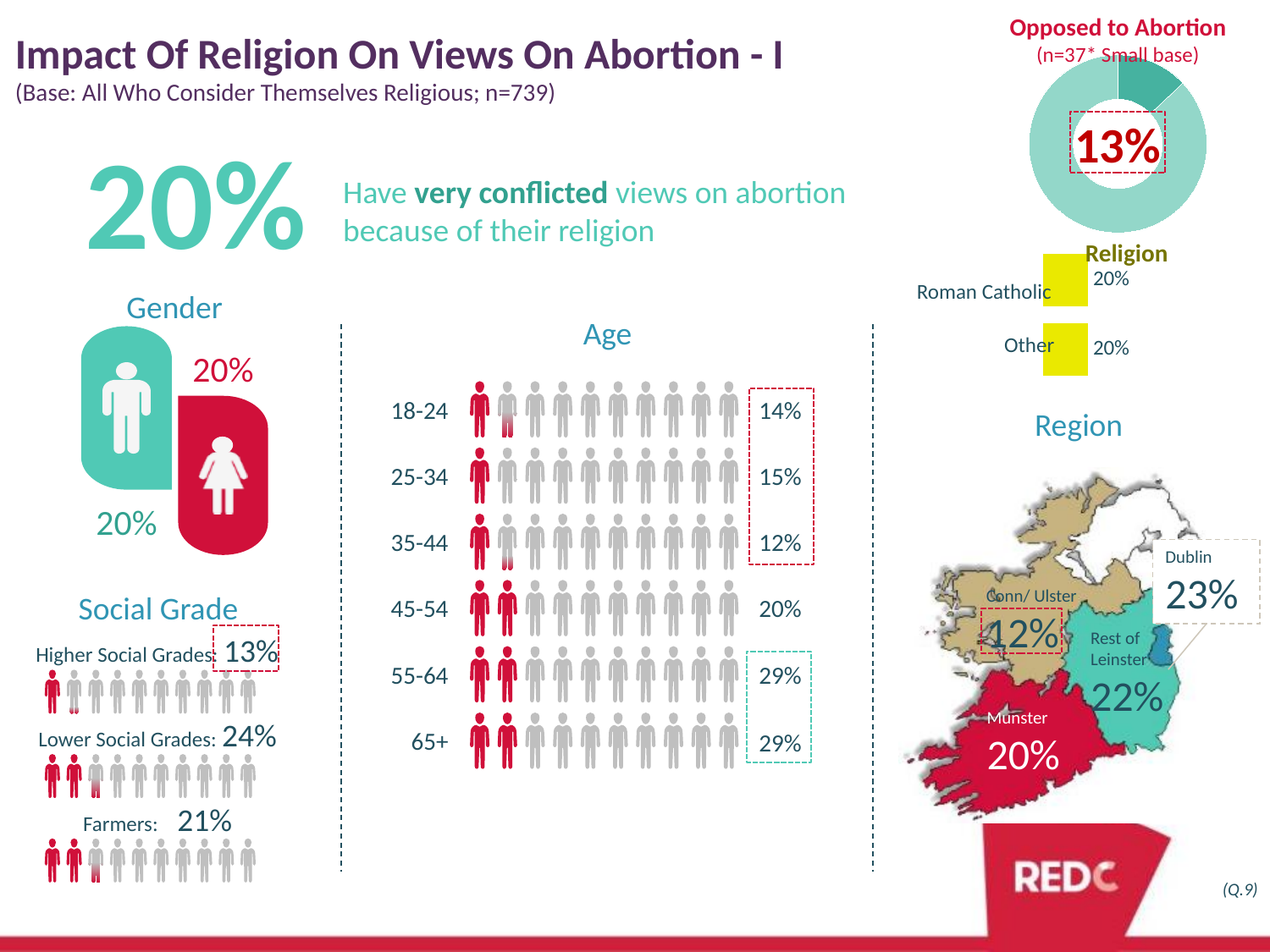
In the Age chart, what is the value for the 35-44 age group? 12% In the Age chart, which is larger, the value for 45-54 or the value for 25-34? 45-54 In the Religion bar chart, how many categories are shown? 2 In the Age chart, what is the difference between the values for 55-64 and 18-24? 15% In the Age chart, do the values generally rise or fall from the youngest to the oldest age group? rise In the Region map, which region has the highest value? Dublin In the Opposed to Abortion donut chart, what percentage is shown? 13% In the Age chart, which age group has the lowest value? 35-44 In the Age chart, how many age groups are shown? 6 In the Social Grade chart, what is the difference between Lower Social Grades and Higher Social Grades? 11% In the Age chart, what is the value for the 65+ age group? 29% In the Religion bar chart, what is the value for Roman Catholic? 20%